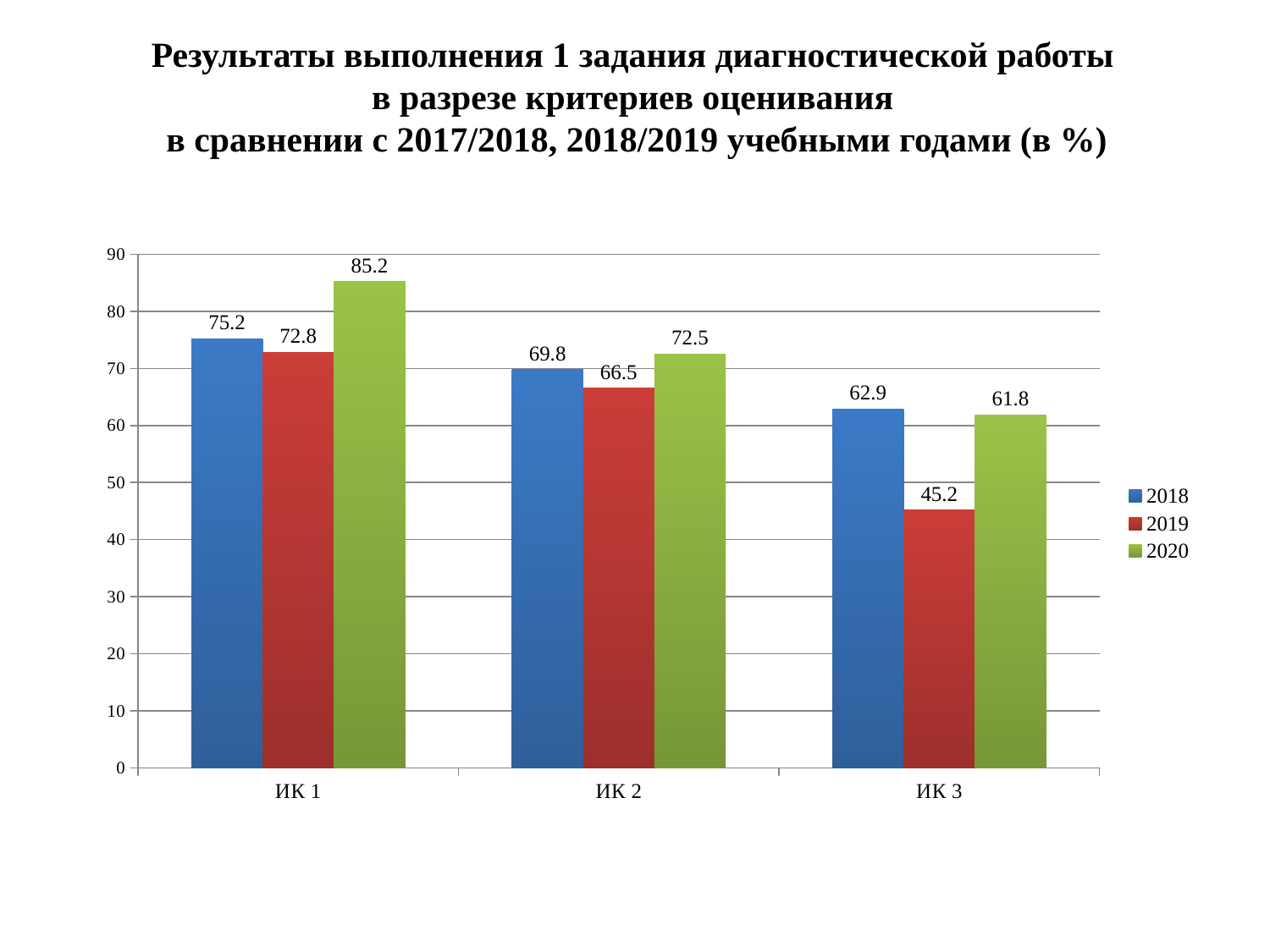
How many series does the legend list? 3 What is the value for 2018 in category ИК 2? 69.8 Do the values for the 2018 series rise or fall from ИК 1 to ИК 3? Fall Which category has the lowest value for the 2019 series? ИК 3 What is the difference between the 2018 and 2019 values in category ИК 1? 2.4 What is the difference between the 2020 and 2019 values in category ИК 3? 16.6 How many categories are shown on the x axis? 3 Which category has the highest value for the 2020 series? ИК 1 What kind of chart is shown on the slide? Bar chart What is the value for 2020 in category ИК 1? 85.2 Which is larger in category ИК 2: the 2018 value or the 2019 value? 2018 What is the value for 2019 in category ИК 3? 45.2